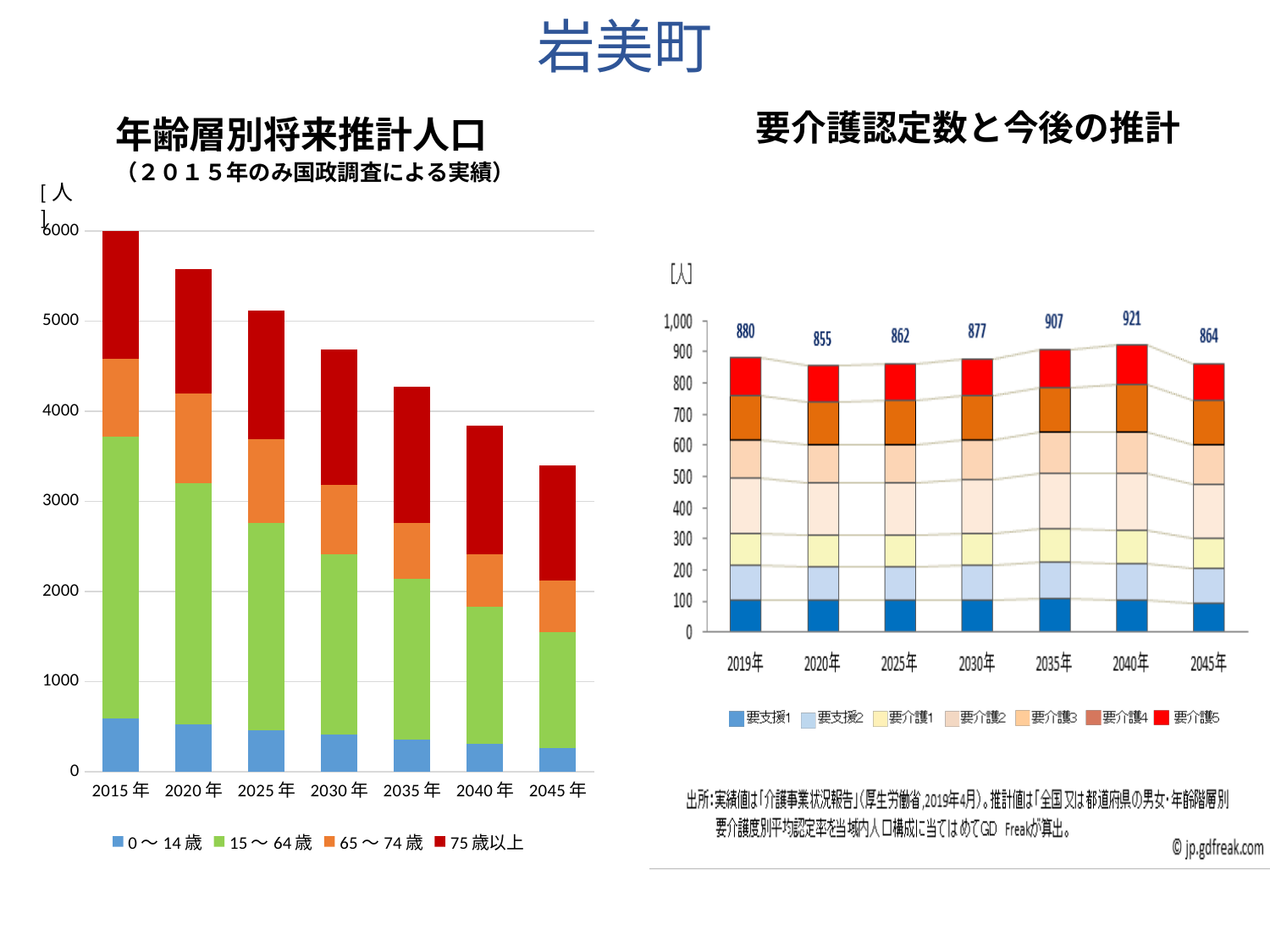
In the chart titled 要介護認定数と今後の推計, what is the total value shown for 2019年? 880 In the chart titled 要介護認定数と今後の推計, what is the difference between the totals for 2040年 and 2020年? 66 In the chart titled 年齢層別将来推計人口, how many age groups does the legend list? 4 In the chart titled 年齢層別将来推計人口, do the total bar heights rise or fall from 2015年 to 2045年? fall In the chart titled 要介護認定数と今後の推計, which year has the lowest total? 2020年 In the chart titled 年齢層別将来推計人口, is the total bar height for 2045年 greater or less than 4000? less What kind of chart is the chart titled 年齢層別将来推計人口? Stacked bar chart In the chart titled 要介護認定数と今後の推計, what is the total value shown for 2040年? 921 In the chart titled 年齢層別将来推計人口, how many years are shown on the x axis? 7 In the chart titled 要介護認定数と今後の推計, which is larger, the total for 2035年 or the total for 2045年? 2035年 In the chart titled 要介護認定数と今後の推計, how many series does the legend list? 7 In the chart titled 要介護認定数と今後の推計, which year has the highest total? 2040年